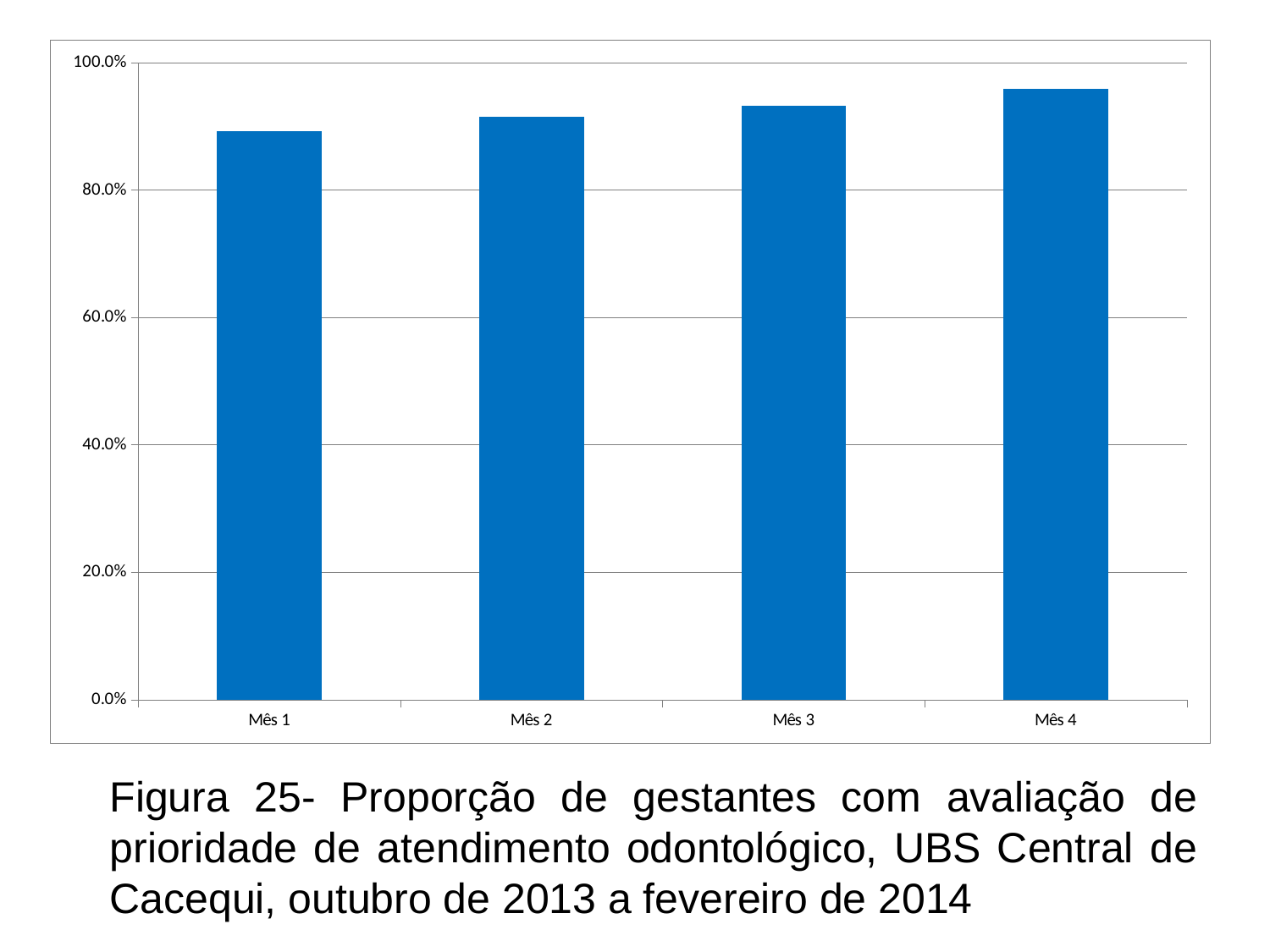
Which month has the highest bar? Mês 4 Which is larger, the value for Mês 1 or the value for Mês 4? Mês 4 What is the highest value shown on the y axis? 100.0% Is the value for Mês 3 greater or less than 60.0%? greater Is the value for Mês 4 greater or less than 100.0%? less How many categories (months) are plotted on the chart? 4 Which month has the lowest bar? Mês 1 What kind of chart is shown on the slide? bar chart Is the value for Mês 2 greater or less than 80.0%? greater What is the label of the first category on the x axis? Mês 1 Do the values rise or fall from Mês 1 to Mês 4? rise